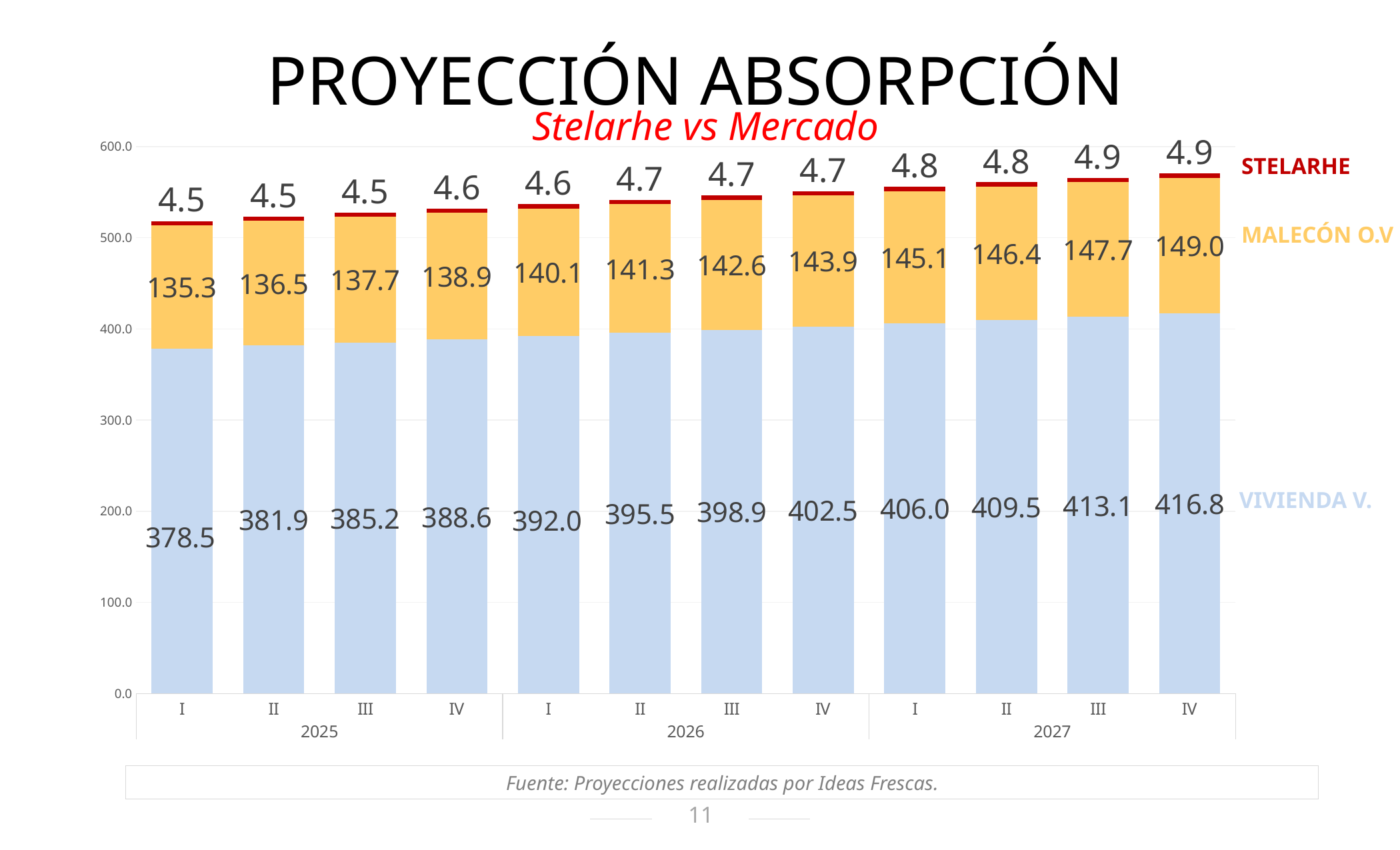
Is the total of the stacked bar for quarter I of 2025 greater or less than 500? greater What is the MALECÓN O.V value for quarter III of 2026? 142.6 What is the difference between the VIVIENDA V. value in quarter IV of 2027 and quarter I of 2025? 38.3 How many quarters (bars) are shown on the chart? 12 How many series does the chart show? 3 What kind of chart is shown on the slide? Stacked bar chart In which quarter is the VIVIENDA V. value highest? IV 2027 What is the STELARHE value for quarter IV of 2027? 4.9 What is the total of the stacked bar for quarter IV of 2027? 570.7 In which quarter is the MALECÓN O.V value lowest? I 2025 What is the VIVIENDA V. value for quarter I of 2025? 378.5 Which is larger in quarter II of 2026: the VIVIENDA V. value or the MALECÓN O.V value? VIVIENDA V.